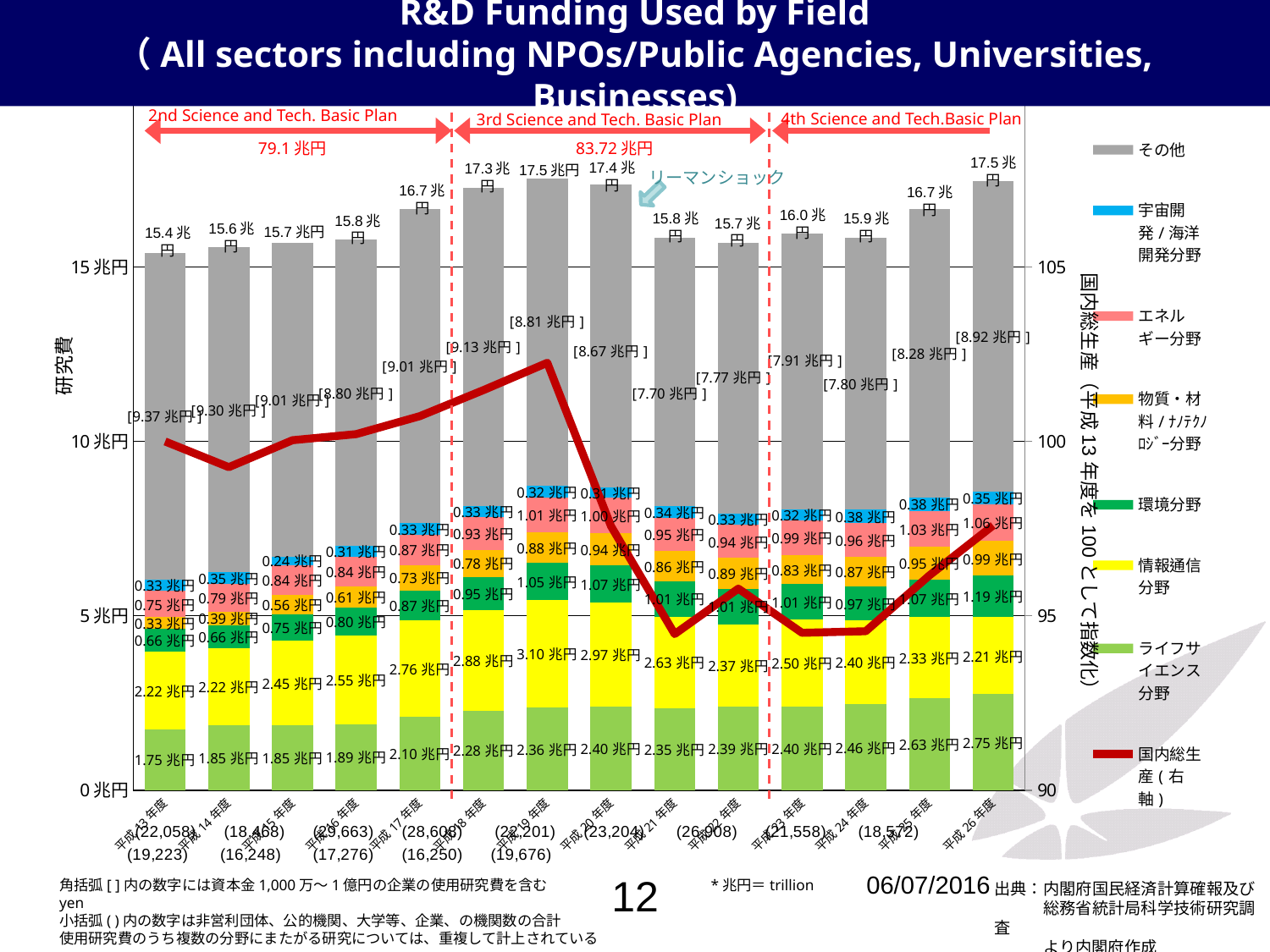
How many fiscal years are plotted on the x axis? 14 Does the ライフサイエンス分野 value rise or fall from 平成13年度 to 平成26年度? rise Which is larger, the total R&D funding for 平成17年度 or for 平成21年度? 平成17年度 How many entries does the legend list? 8 What is the total R&D funding shown above the bar for 平成18年度? 17.3 兆円 What is the difference between the ライフサイエンス分野 values for 平成26年度 and 平成13年度? 1.00 兆円 What is the value of the 情報通信分野 segment for 平成19年度? 3.10 兆円 Which fiscal year has the highest ライフサイエンス分野 value? 平成26年度 (2.75 兆円) Which fiscal year has the lowest total R&D funding label? 平成13年度 (15.4 兆円) What kind of chart is used to show the R&D funding by field? stacked bar chart (with a line for GDP) Is the 国内総生産 (right axis) line value for 平成19年度 greater or less than 100? greater What is the value of the ライフサイエンス分野 segment for 平成17年度? 2.10 兆円